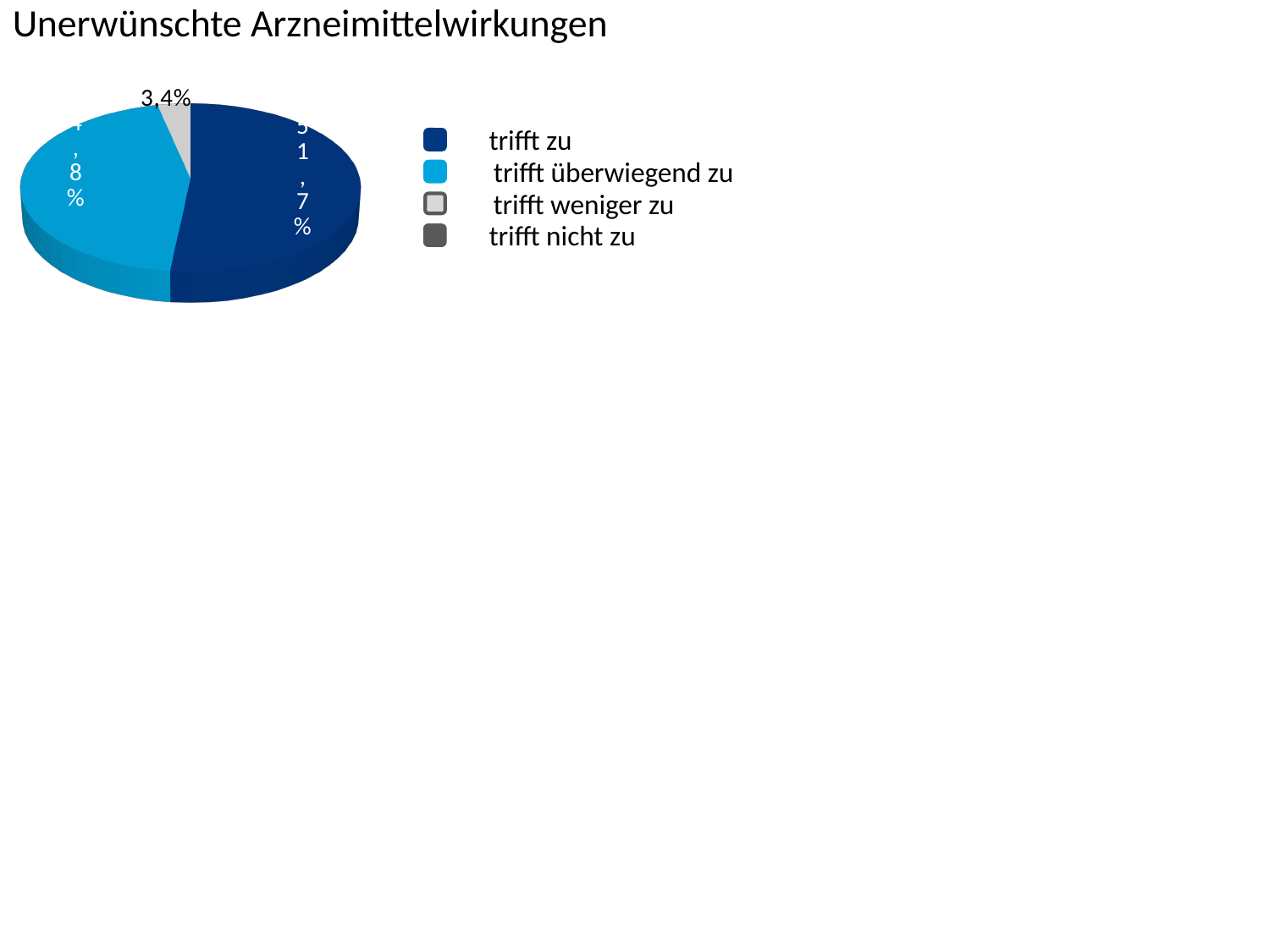
What colour represents "trifft zu" in the pie chart? dark blue Which of the labelled slices is the smallest? trifft weniger zu What is the share for "trifft zu"? 51,7% What is the title of the slide? Unerwünschte Arzneimittelwirkungen What is the difference between the shares for "trifft zu" and "trifft weniger zu"? 48,3 percentage points Which category has the largest slice of the pie? trifft zu What kind of chart is shown on the slide? pie chart How many entries does the legend list? 4 Is the share for "trifft zu" greater or less than 50%? greater What is the share for "trifft weniger zu"? 3,4% Which slice is larger, "trifft zu" or "trifft überwiegend zu"? trifft zu